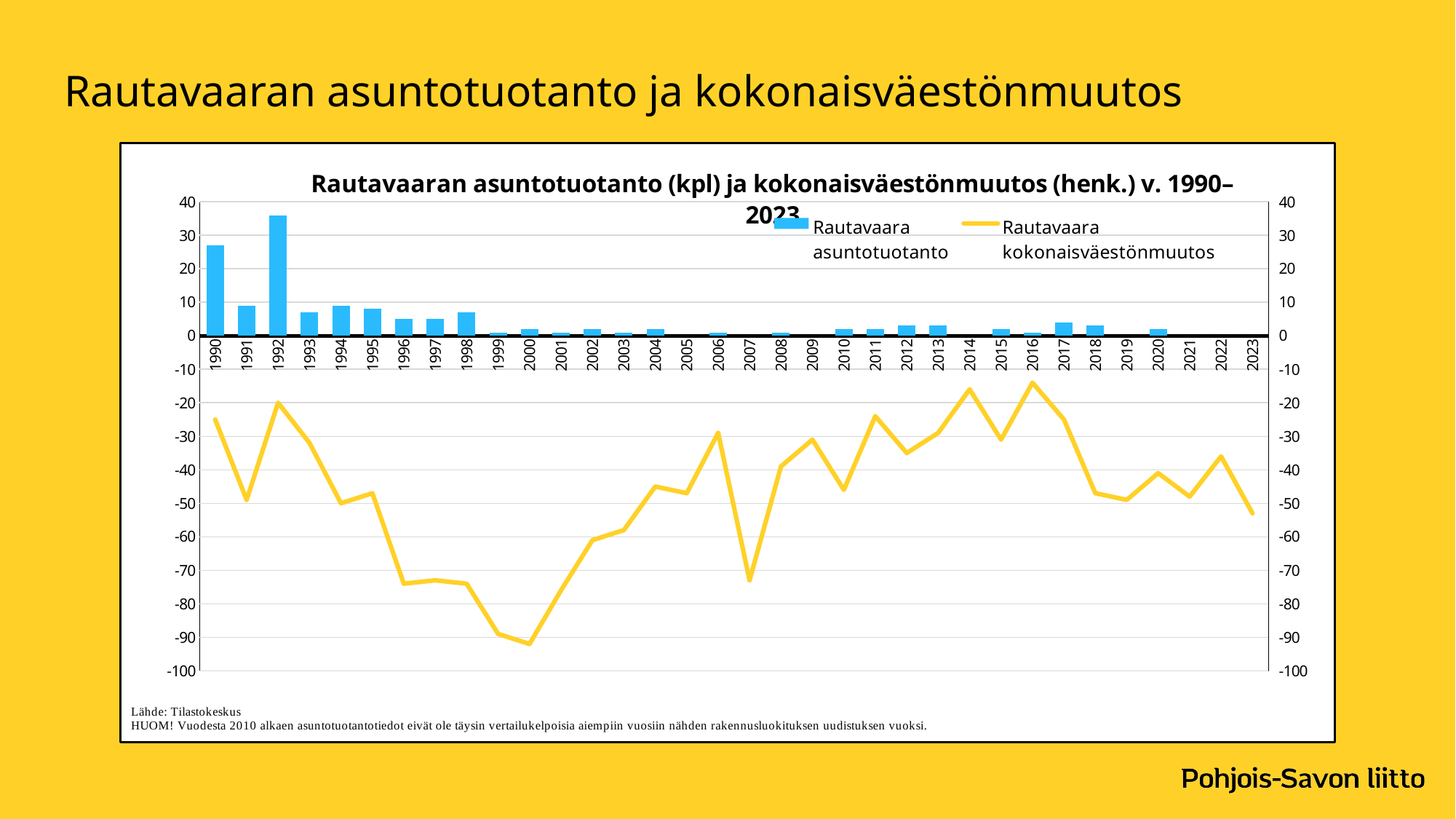
Is the Rautavaara asuntotuotanto bar for 1992 greater or less than 30? greater Is the Rautavaara kokonaisväestönmuutos value for 2000 greater or less than -80? less Which year has the higher Rautavaara kokonaisväestönmuutos value, 1999 or 2016? 2016 What kind of chart is shown on the slide? Combined bar and line chart In which year does the Rautavaara kokonaisväestönmuutos line reach its lowest point? 2000 Is the Rautavaara asuntotuotanto bar for 1990 greater or less than 20? greater Which year has the larger Rautavaara asuntotuotanto bar, 1990 or 1992? 1992 How many series does the chart legend list? 2 How many years are shown on the x axis of the chart? 34 Which year has the tallest bar for Rautavaara asuntotuotanto? 1992